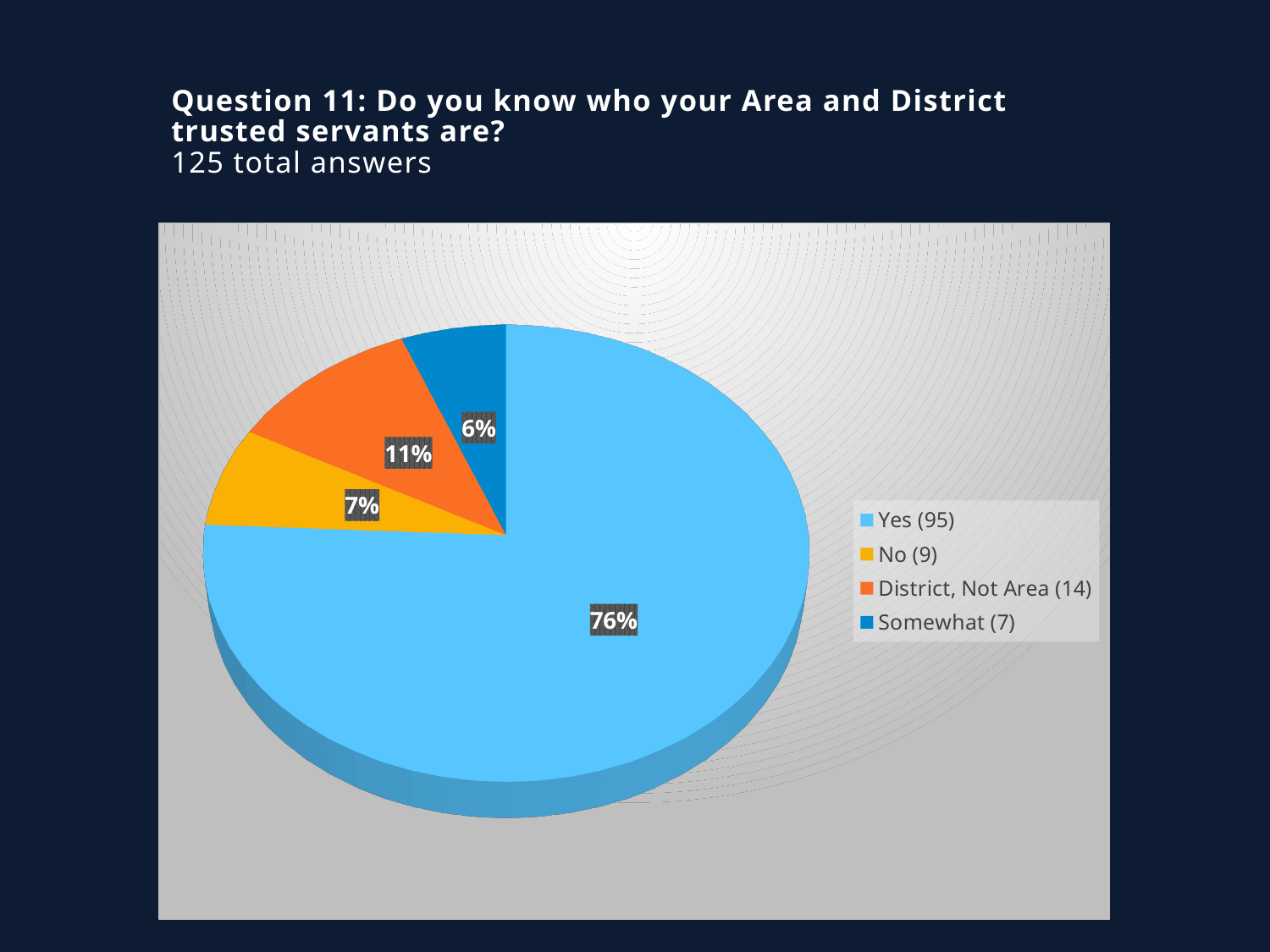
What colour is the "Yes (95)" slice in the legend? Light blue Which category has the smallest slice of the pie? Somewhat (7) What kind of chart is shown on the slide? Pie chart Which category has the largest slice of the pie? Yes (95) What is the difference in percentage points between the "Yes (95)" slice and the "District, Not Area (14)" slice? 65 What percentage of the pie does the "Somewhat (7)" slice represent? 6% What percentage of the pie does the "No (9)" slice represent? 7% What percentage of the pie does the "Yes (95)" slice represent? 76% How many total answers does the slide say the chart is based on? 125 How many categories does the pie chart show? 4 What percentage of the pie does the "District, Not Area (14)" slice represent? 11% Which slice is larger, "No (9)" or "District, Not Area (14)"? District, Not Area (14)